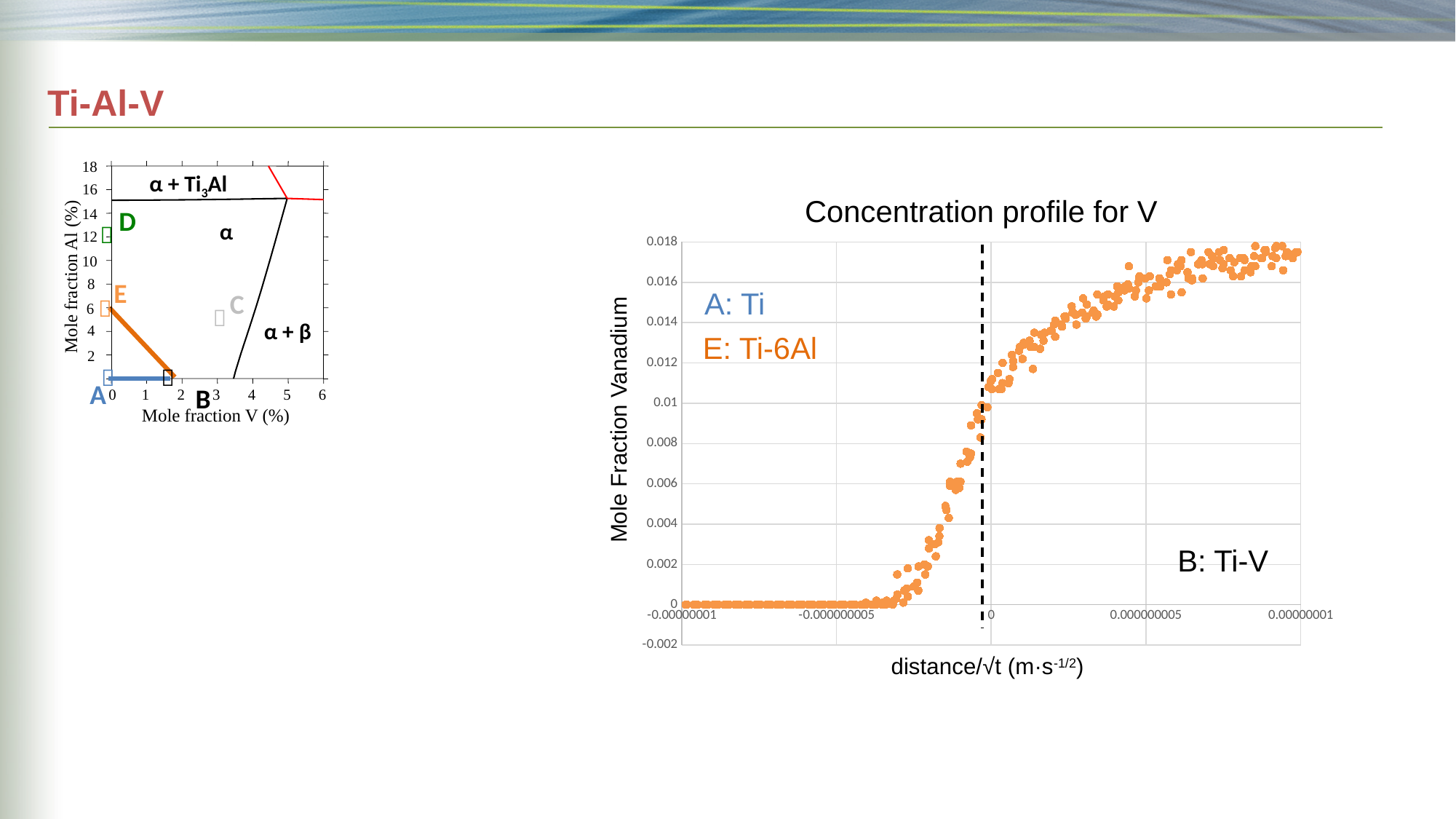
In the 'Concentration profile for V' chart, is the value at x = 0.000000005 greater or less than 0.014? greater In the phase diagram on the left of the slide, what is the x-axis label? Mole fraction V (%) In the 'Concentration profile for V' chart, is the value at x = -0.000000005 greater or less than 0.002? less What kind of chart is the 'Concentration profile for V' chart? scatter chart In the phase diagram on the left of the slide, which point has a higher mole fraction Al, D or E? D In the phase diagram on the left of the slide, what is the mole fraction Al (%) of point D? 12 In the phase diagram on the left of the slide, what is the mole fraction Al (%) of point E? 6 What is the title of the chart on the right of the slide? Concentration profile for V What is the y-axis label of the 'Concentration profile for V' chart? Mole Fraction Vanadium In the 'Concentration profile for V' chart, what is the highest value shown on the y axis? 0.018 In the 'Concentration profile for V' chart, is the value at x = 0.00000001 greater or less than 0.016? greater In the 'Concentration profile for V' chart, do the plotted values rise or fall as the x axis increases? rise